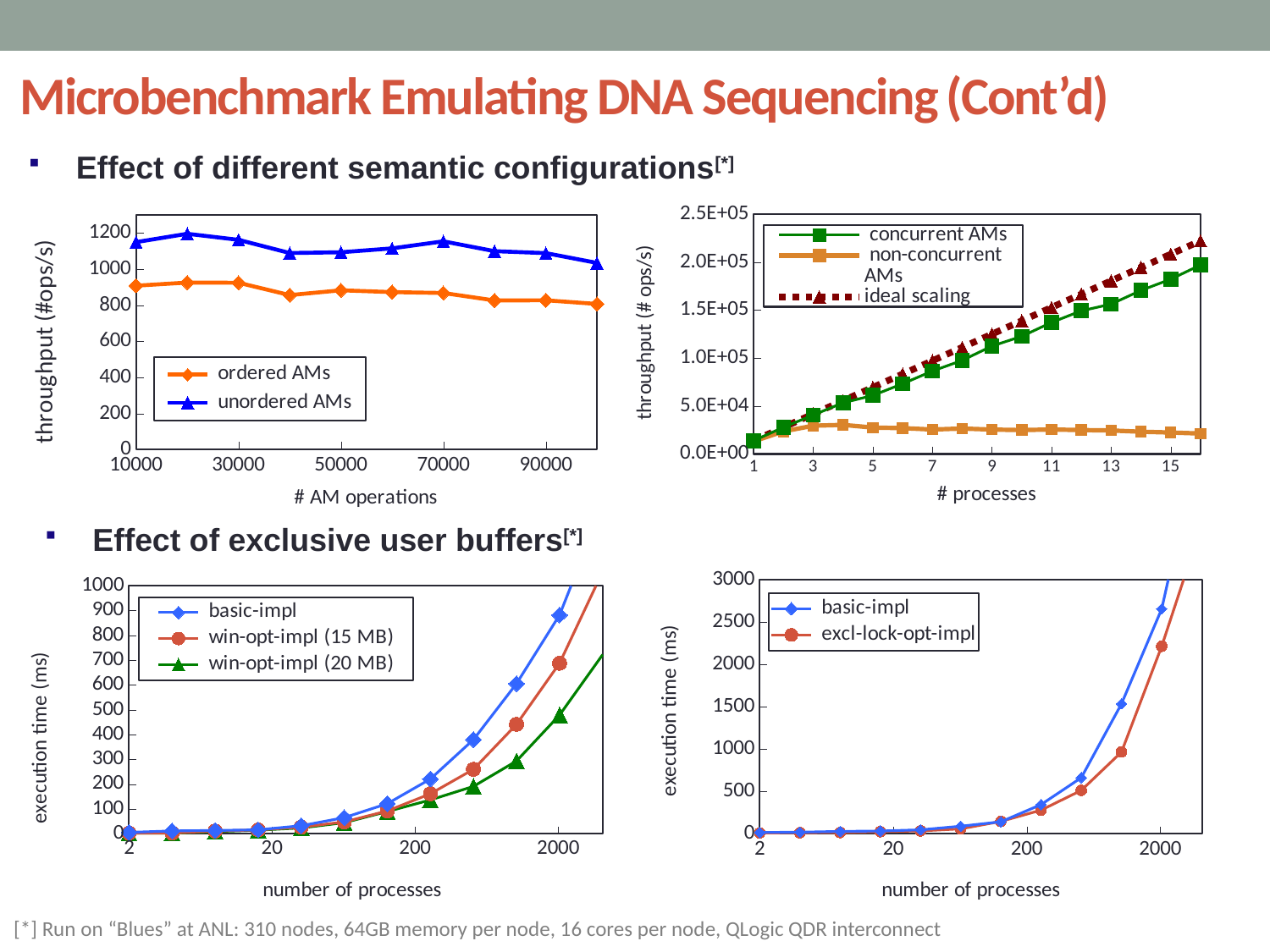
How many series does the legend of the bottom-right chart (execution time vs number of processes) list? 2 In the top-left chart (throughput vs # AM operations), is the throughput of ordered AMs at 90000 operations greater or less than 1000? less In the top-left chart (throughput vs # AM operations), which series has higher throughput, ordered AMs or unordered AMs? unordered AMs In the top-right chart (throughput vs # processes), does the throughput of concurrent AMs rise or fall as the number of processes increases? rise In the bottom-right chart (execution time vs number of processes), is the execution time of basic-impl at 2000 processes greater or less than 2000? greater In the top-left chart (throughput vs # AM operations), is the throughput of unordered AMs at 10000 operations greater or less than 1000? greater What kind of chart is the top-left chart (throughput vs # AM operations)? line chart How many series does the legend of the bottom-left chart (execution time vs number of processes) list? 3 How many series does the legend of the top-right chart (throughput vs # processes) list? 3 In the bottom-left chart (execution time vs number of processes), which series has the higher execution time at 2000 processes, basic-impl or win-opt-impl (20 MB)? basic-impl